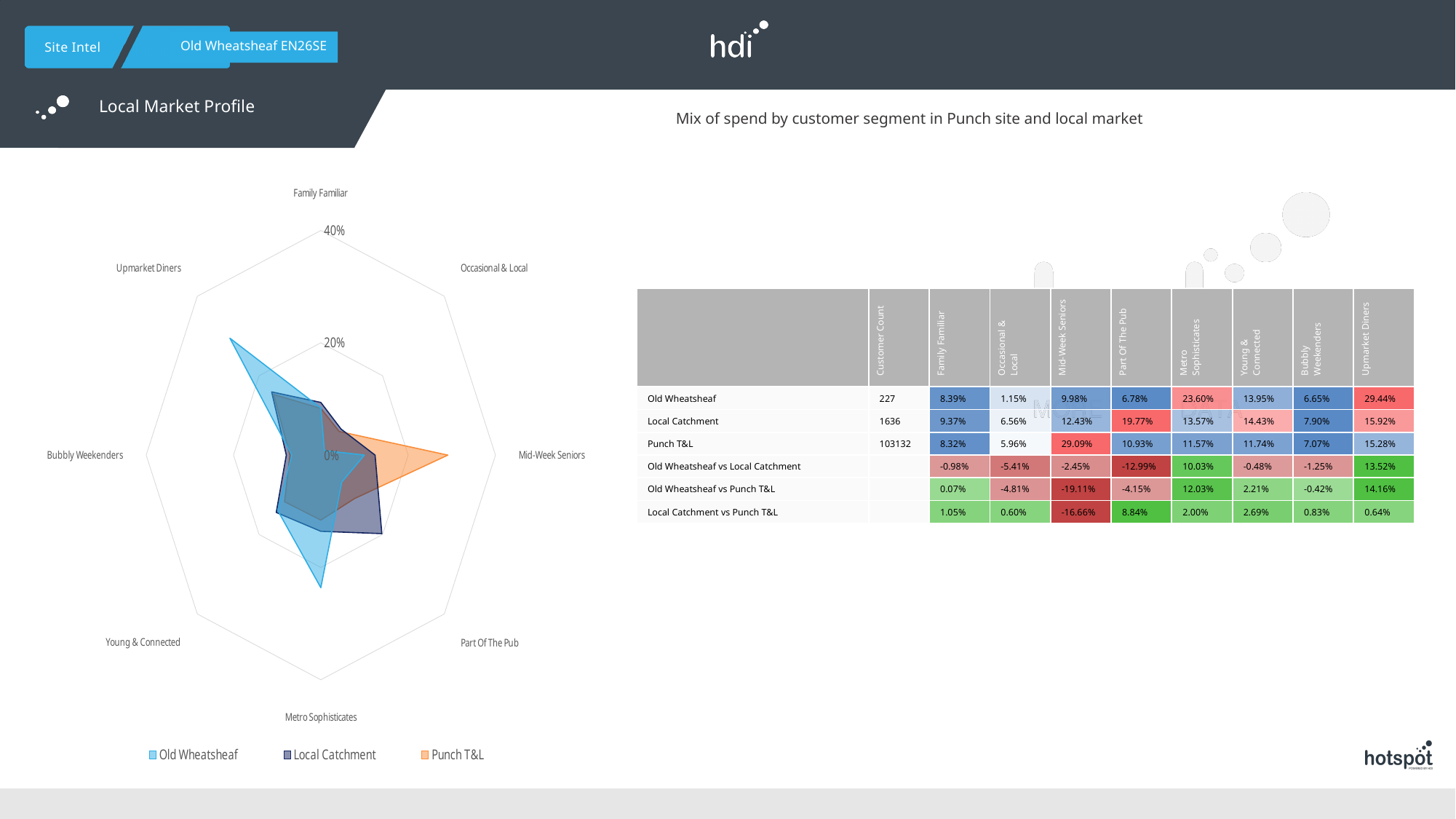
In the radar chart, which customer segment has the highest value for Old Wheatsheaf? Upmarket Diners What is the Local Catchment value for Part Of The Pub? 19.77% What is the Old Wheatsheaf value for Upmarket Diners? 29.44% What colour represents Punch T&L in the radar chart? orange What is the Punch T&L value for Mid-Week Seniors? 29.09% For Part Of The Pub, which is larger: the Old Wheatsheaf value or the Local Catchment value? Local Catchment In the radar chart, is the Old Wheatsheaf value for Upmarket Diners greater or less than 20%? greater How many series does the radar chart's legend list? 3 What is the difference between the Old Wheatsheaf and Local Catchment values for Upmarket Diners? 13.52% How many customer segment categories does the radar chart have? 8 In the radar chart, which customer segment has the highest value for Punch T&L? Mid-Week Seniors What kind of chart is shown on the left of the slide? radar chart